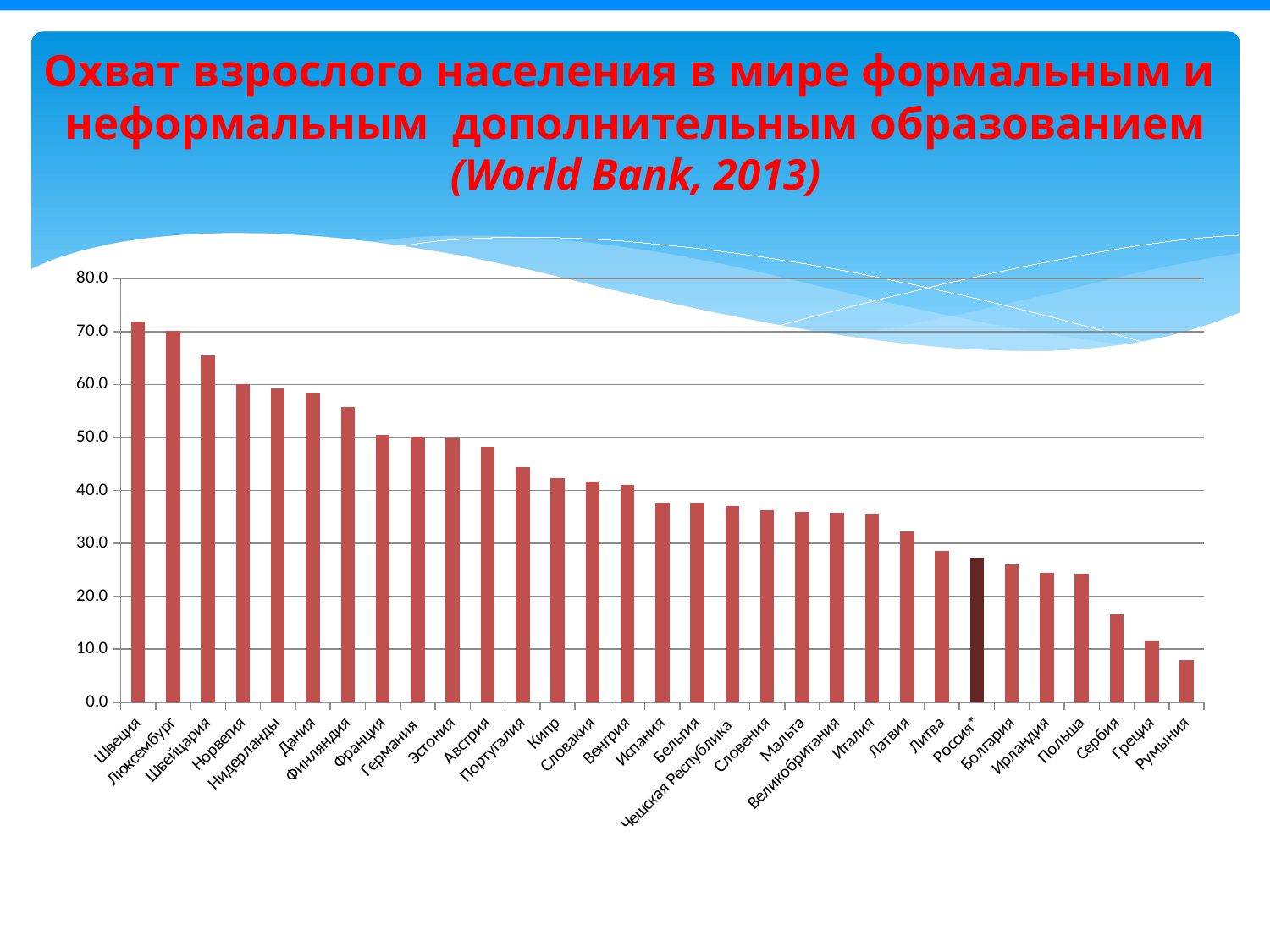
Which country's bar is drawn in a darker colour than the others? Россия* How many countries are shown in the chart? 31 Which country has the highest value in the chart? Швеция Do the values rise or fall from left to right along the x axis? fall Which has the larger value, Сербия or Литва? Литва Is the value for Румыния greater or less than 10.0? less What kind of chart is shown on the slide? bar chart Is the value for Финляндия greater or less than 50.0? greater Is the value for Швеция greater or less than 70.0? greater Which has the larger value, Дания or Финляндия? Дания Which country has the lowest value in the chart? Румыния